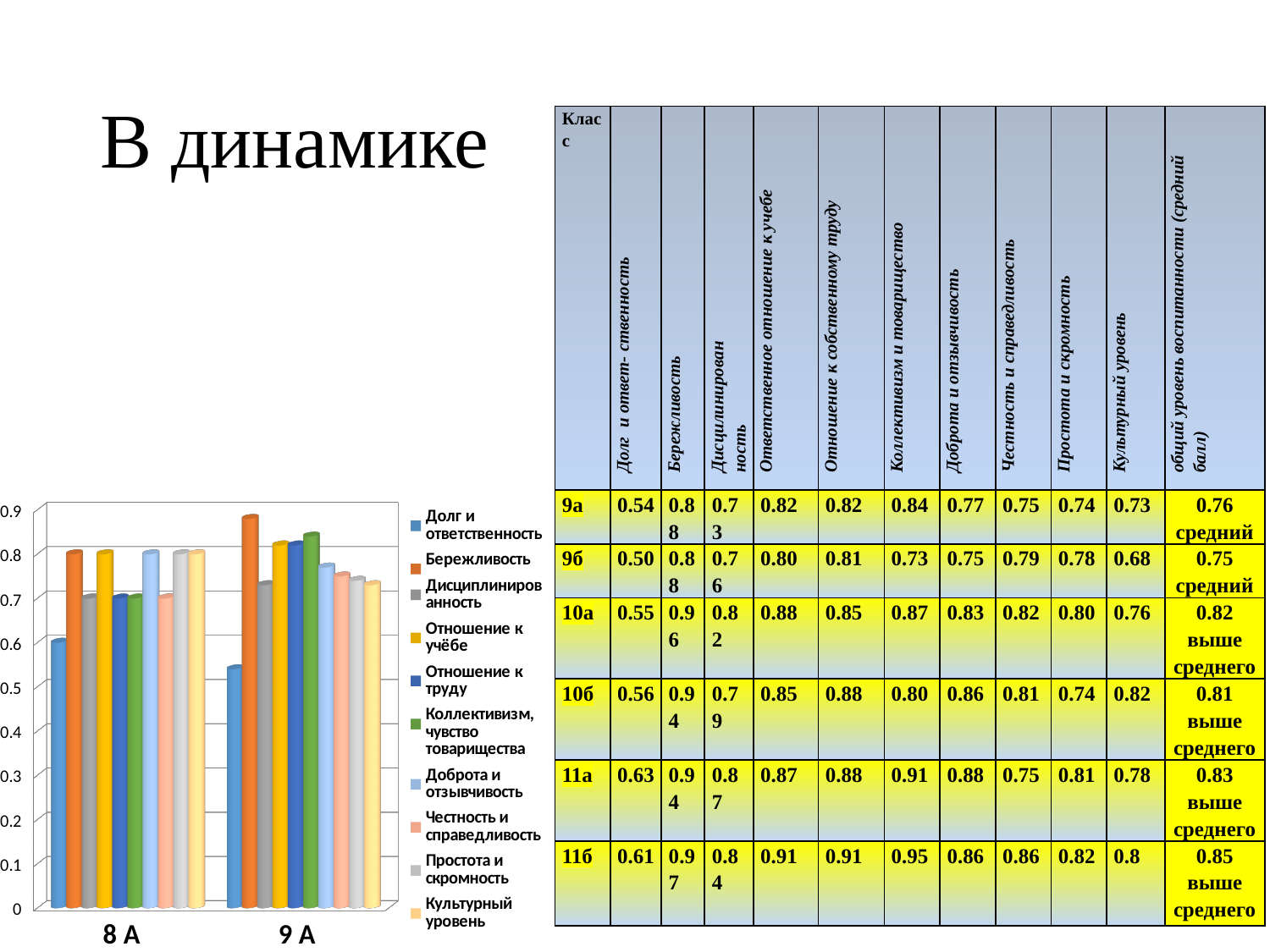
What are the two category labels on the x axis of the bar chart? 8 А and 9 А How many series does the legend of the bar chart list? 10 In the bar chart, which is larger: Коллективизм, чувство товарищества for 8 А or for 9 А? 9 А In the bar chart, is the value of Доброта и отзывчивость for 9 А greater or less than 0.8? less In the bar chart, which series has the lowest value for 9 А? Долг и ответственность What kind of chart is shown on the left of the slide? bar chart In the bar chart, which series has the lowest value for 8 А? Долг и ответственность In the bar chart, is the value of Бережливость for 9 А greater or less than 0.8? greater How many categories are shown on the x axis of the bar chart? 2 In the bar chart, which series has the highest value for 9 А? Бережливость In the bar chart, is the value of Долг и ответственность for 9 А greater or less than 0.6? less In the bar chart, which is larger: Долг и ответственность for 8 А or for 9 А? 8 А